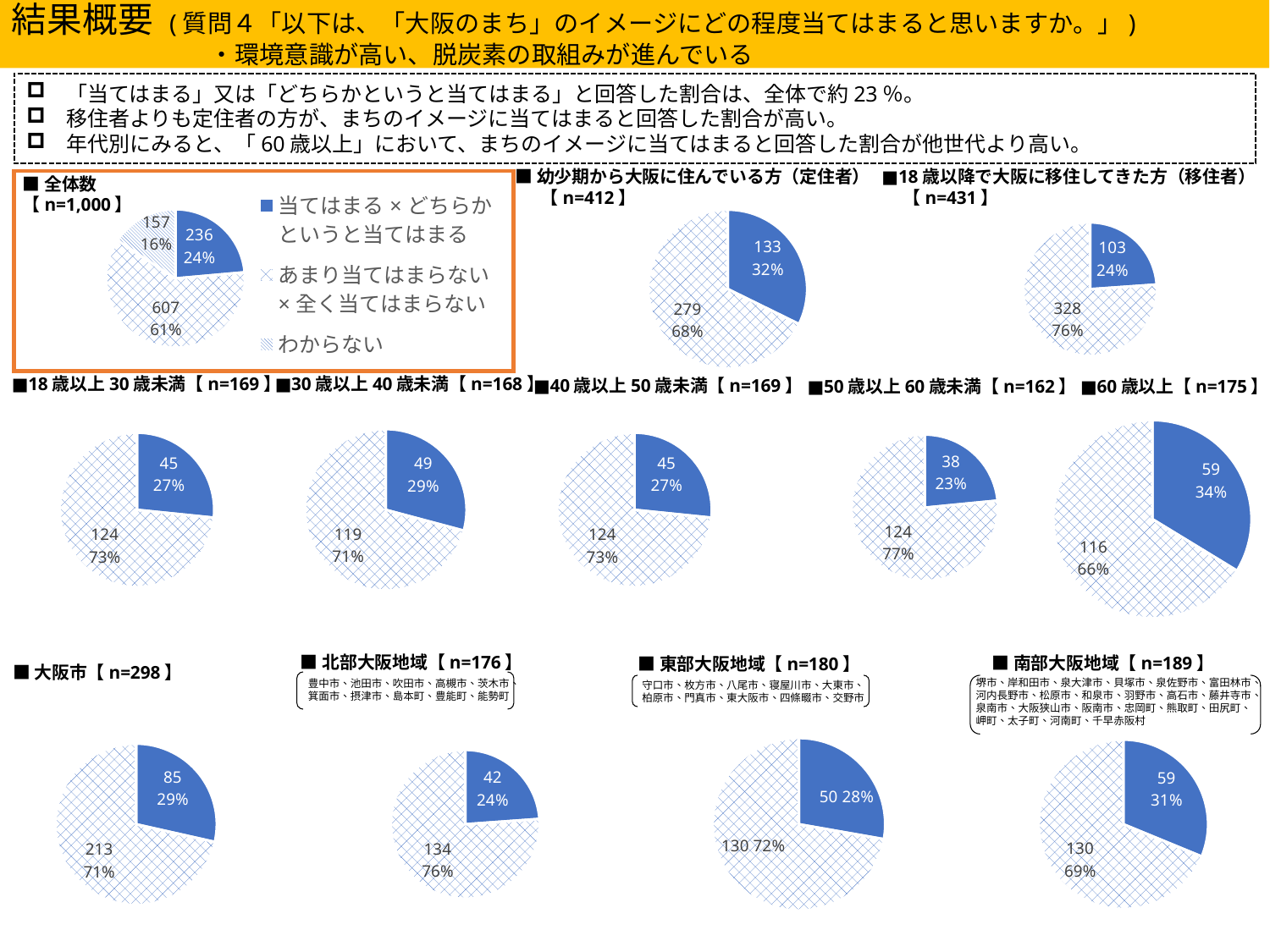
「幼少期から大阪に住んでいる方（定住者）【n=412】」の円グラフで、「当てはまる×どちらかというと当てはまる」の割合は何%ですか。 32% 「東部大阪地域【n=180】」の円グラフで、「当てはまる×どちらかというと当てはまる」の値はいくつですか。 50 「60歳以上【n=175】」と「50歳以上60歳未満【n=162】」の円グラフで、「当てはまる×どちらかというと当てはまる」の値の差はいくつですか。 21 年代別の5つの円グラフのうち、「当てはまる×どちらかというと当てはまる」の割合が最も低いのはどの年代ですか。 50歳以上60歳未満 「幼少期から大阪に住んでいる方（定住者）」と「18歳以降で大阪に移住してきた方（移住者）」の円グラフで、「当てはまる×どちらかというと当てはまる」の割合が高いのはどちらですか。 幼少期から大阪に住んでいる方（定住者） 「全体数【n=1,000】」の円グラフで、「当てはまる×どちらかというと当てはまる」の値はいくつですか。 236 「全体数【n=1,000】」の円グラフの凡例には、いくつの項目がありますか。 3 「全体数【n=1,000】」の円グラフで、「わからない」の割合は何%ですか。 16% このスライドで使われているグラフの種類は何ですか。 円グラフ 「18歳以降で大阪に移住してきた方（移住者）【n=431】」の円グラフで、「あまり当てはまらない×全く当てはまらない」の値はいくつですか。 328 「60歳以上【n=175】」の円グラフで、「当てはまる×どちらかというと当てはまる」の値はいくつですか。 59 「大阪市【n=298】」の円グラフで、「あまり当てはまらない×全く当てはまらない」の割合は何%ですか。 71%